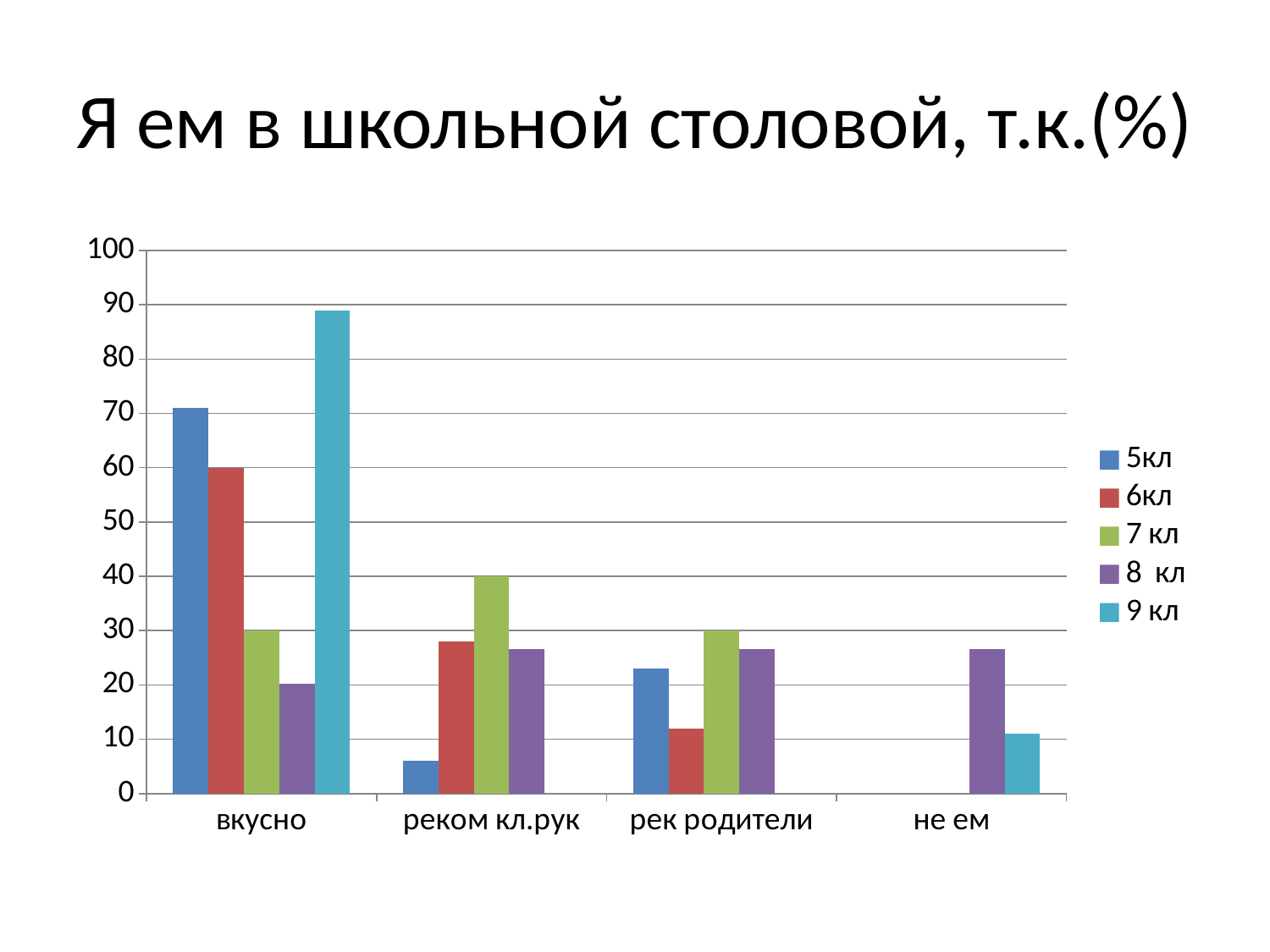
Is the value for 9 кл in the category вкусно greater or less than 80? greater How many categories are shown on the x axis? 4 Which series has the lowest value in the category реком кл.рук? 5кл In the category вкусно, which is larger: the value for 5кл or the value for 6кл? 5кл What is the value for 6кл in the category вкусно? 60 What is the value for 7 кл in the category рек родители? 30 What kind of chart is shown on the slide? bar chart How many series does the legend list? 5 What is the title of the chart? Я ем в школьной столовой, т.к.(%) Is the value for 5кл in the category реком кл.рук greater or less than 10? less What is the value for 7 кл in the category реком кл.рук? 40 Which series has the highest value in the category вкусно? 9 кл